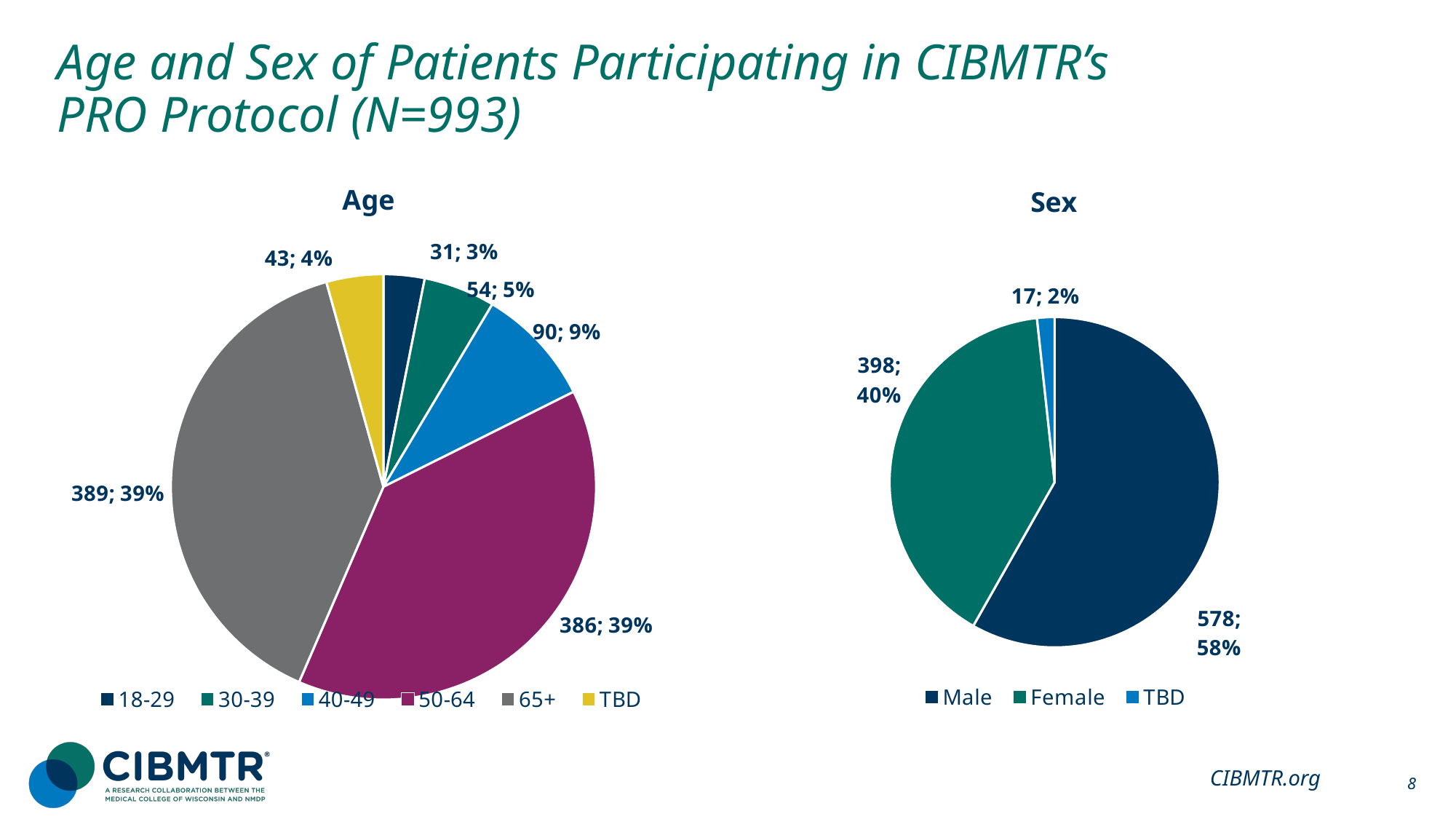
In the Sex chart, what share of patients are female? 40% In the Sex chart, what colour is the Female slice? Teal green In the Age chart, how many patients are in the 40-49 age group? 90 In the Age chart, which age group has the fewest patients? 18-29 What type of chart is the Age chart? Pie chart In the Age chart, what percentage of patients are in the 50-64 age group? 39% In the Sex chart, how many patients are male? 578 In the Sex chart, which category has the largest share? Male In the Sex chart, what is the difference between the number of male and female patients? 180 In the Age chart, how many more patients are in the 40-49 group than in the 30-39 group? 36 In the Age chart, which has more patients: the 30-39 group or the TBD group? 30-39 How many categories does the Age chart's legend list? 6